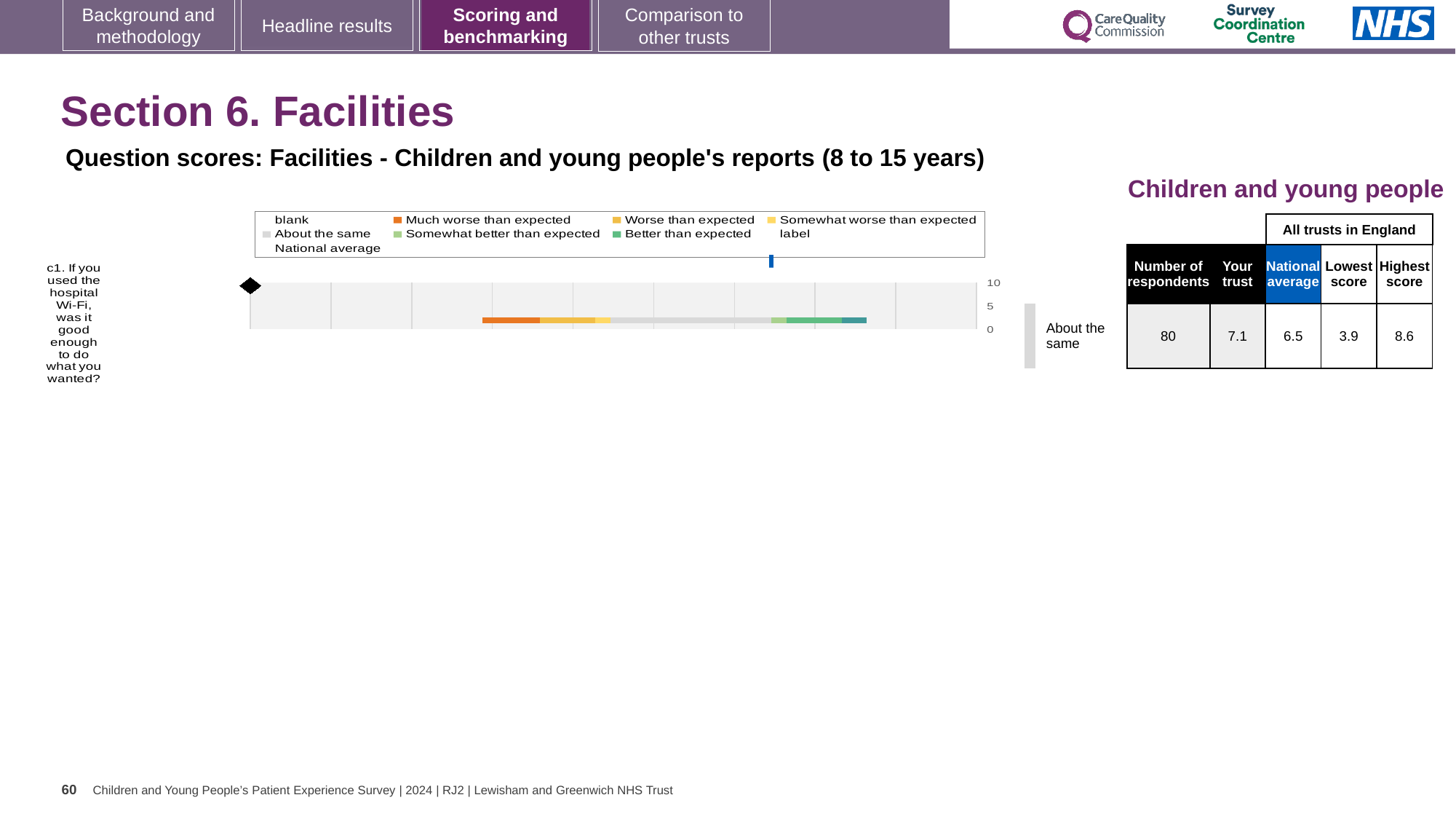
How many respondents answered question c1? 80 Which survey question is shown on the chart? c1. If you used the hospital Wi-Fi, was it good enough to do what you wanted? What is the 'Your trust' score for question c1 about the hospital Wi-Fi? 7.1 How many survey questions are plotted on the chart? 1 What is the highest score among all trusts in England for question c1? 8.6 What is the lowest score among all trusts in England for question c1? 3.9 What is the difference between the highest and lowest trust scores for question c1? 4.7 By how much does the trust's score for c1 exceed the national average? 0.6 Which is higher for question c1: the trust's score or the national average? The trust's score (7.1) What is the national average score for question c1? 6.5 What benchmark category is the trust's result for question c1 placed in? About the same What kind of chart is used to show the question score for c1? Bar chart